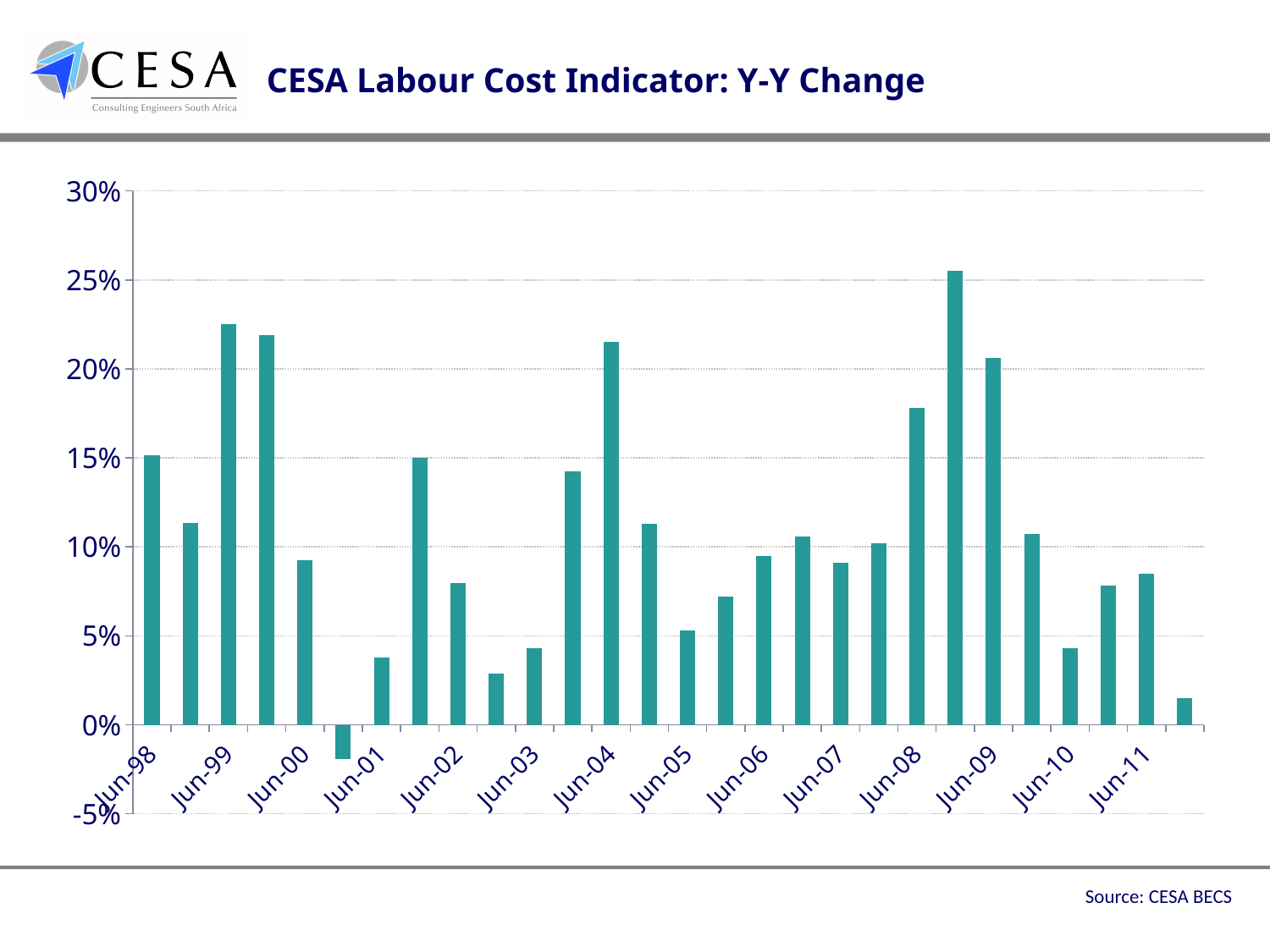
Is the value for Jun-04 greater or less than 20%? greater What is the title of the chart? CESA Labour Cost Indicator: Y-Y Change What source is cited for the chart? CESA BECS What kind of chart is shown on the slide? bar chart Which is larger, the value for Jun-04 or the value for Jun-05? Jun-04 Is the value for Jun-01 greater or less than 5%? less Which is larger, the value for Jun-99 or the value for Jun-00? Jun-99 Is the value for Jun-10 greater or less than 5%? less How many labelled dates appear on the x axis? 14 Does the value rise or fall from Jun-09 to Jun-10? fall